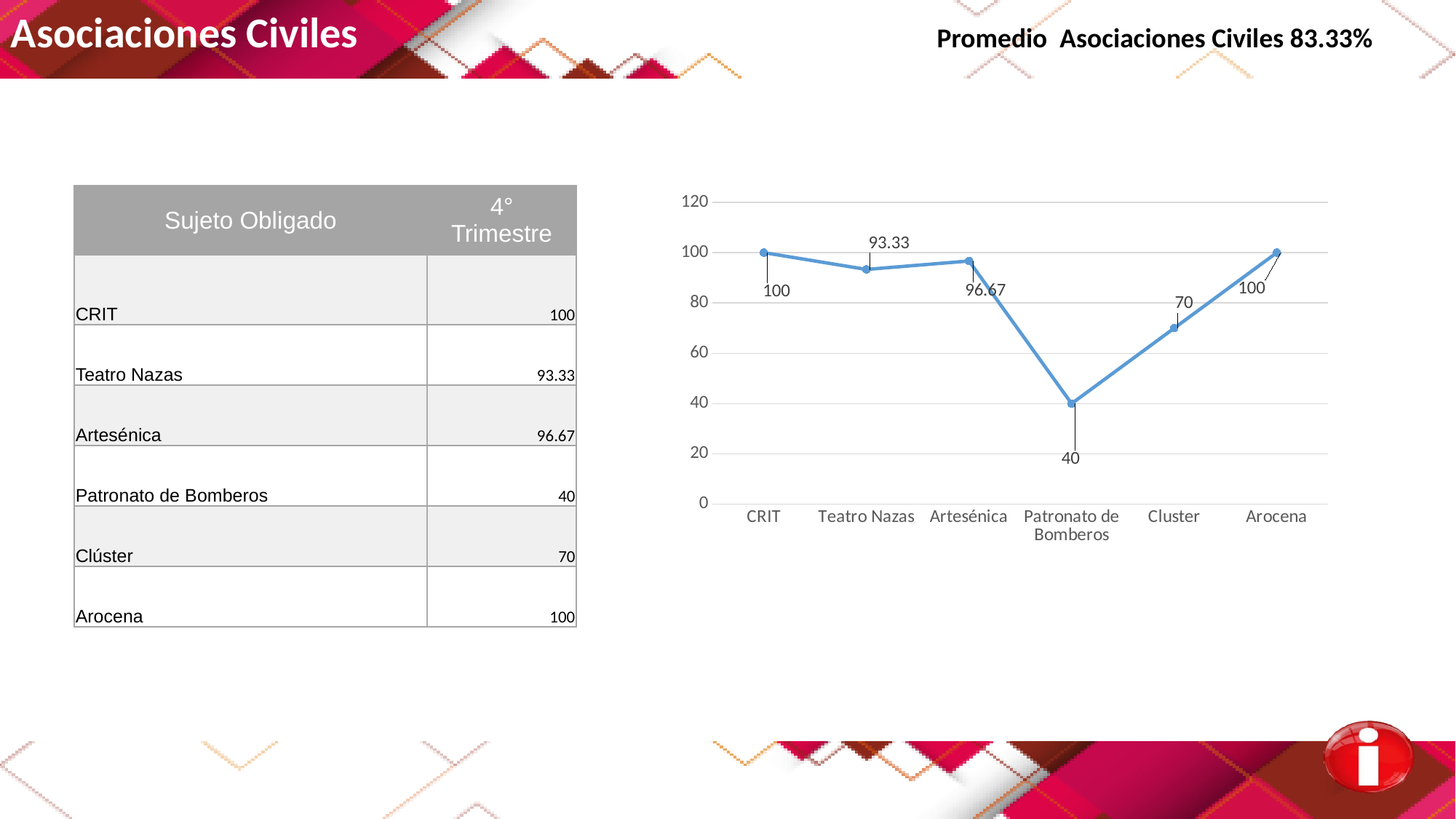
Is the value for Cluster greater or less than 80? less What is the value for Patronato de Bomberos in the chart? 40 Which is larger, the value for Artesénica or the value for Teatro Nazas? Artesénica What kind of chart is shown on the slide? line chart What is the value for Artesénica in the chart? 96.67 How many categories are plotted on the x axis of the chart? 6 What is the difference between the values for CRIT and Teatro Nazas? 6.67 Does the line rise or fall between Patronato de Bomberos and Arocena? rise What is the value for Teatro Nazas in the chart? 93.33 What is the difference between the values for Cluster and Patronato de Bomberos? 30 Which category has the lowest value in the chart? Patronato de Bomberos What is the value for Cluster in the chart? 70